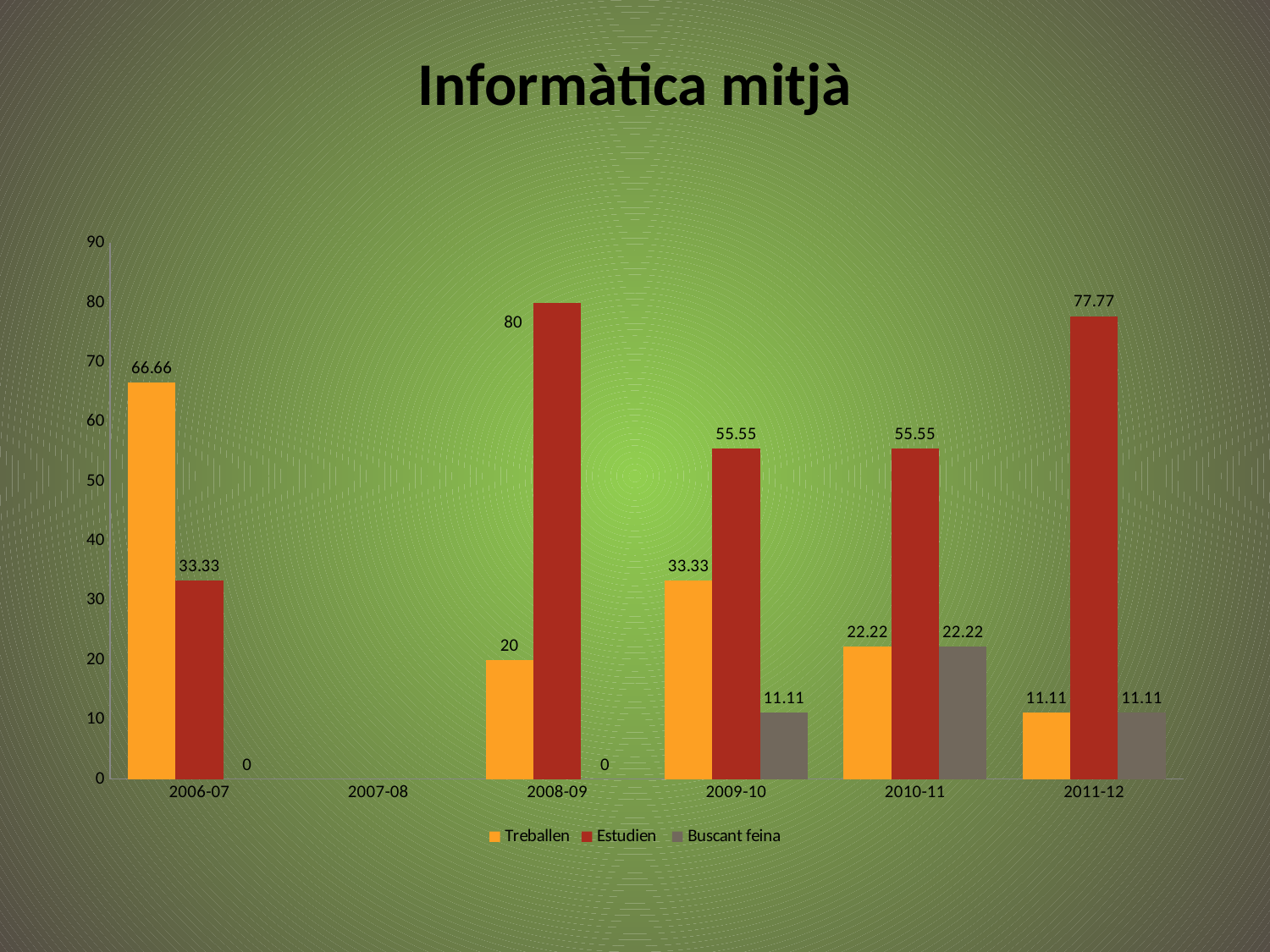
What type of chart is shown on the slide? bar chart How many year categories are shown on the x axis? 6 What is the value for Estudien in 2008-09? 80 How many series does the legend list? 3 What is the value for Buscant feina in 2010-11? 22.22 What is the title of the chart? Informàtica mitjà In which year is the Estudien value highest? 2008-09 In which year is the Treballen value highest? 2006-07 What is the value for Treballen in 2006-07? 66.66 What is the difference between the Estudien and Treballen values in 2009-10? 22.22 What is the value for Estudien in 2011-12? 77.77 Which is larger in 2006-07, Treballen or Estudien? Treballen